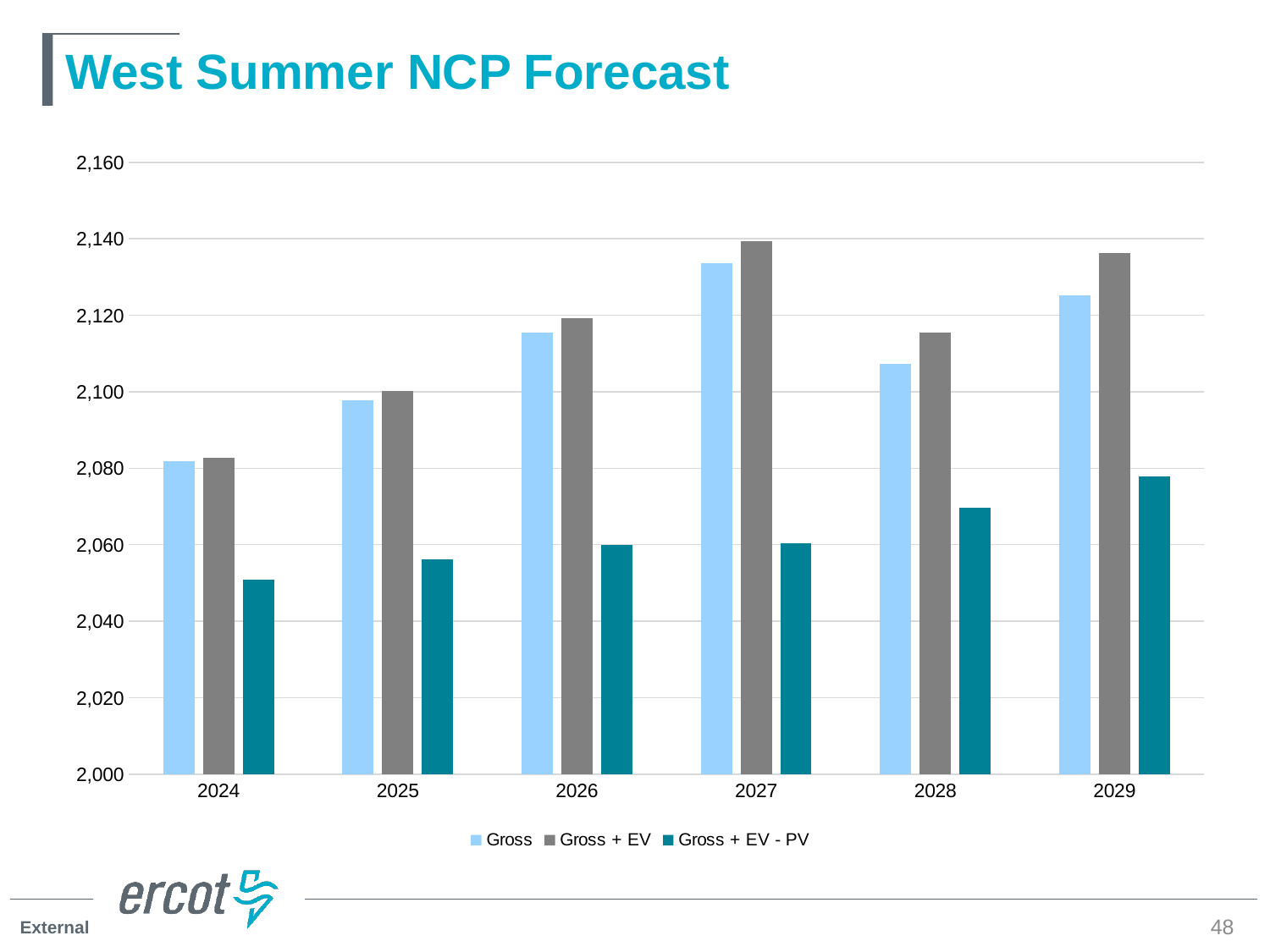
Which year has the highest Gross value? 2027 Which year has the highest Gross + EV - PV value? 2029 Is the Gross value for 2028 greater or less than 2,100? greater Which year has the lowest Gross + EV - PV value? 2024 How many series does the legend list? 3 Which is larger, the Gross value for 2027 or the Gross value for 2029? 2027 Does the Gross + EV - PV series rise or fall from 2024 to 2029? rise What is the title of the chart? West Summer NCP Forecast How many years are shown on the x axis? 6 What kind of chart is shown on the slide? bar chart Is the Gross + EV - PV value for 2024 greater or less than 2,060? less Is the Gross value for 2027 greater or less than 2,120? greater